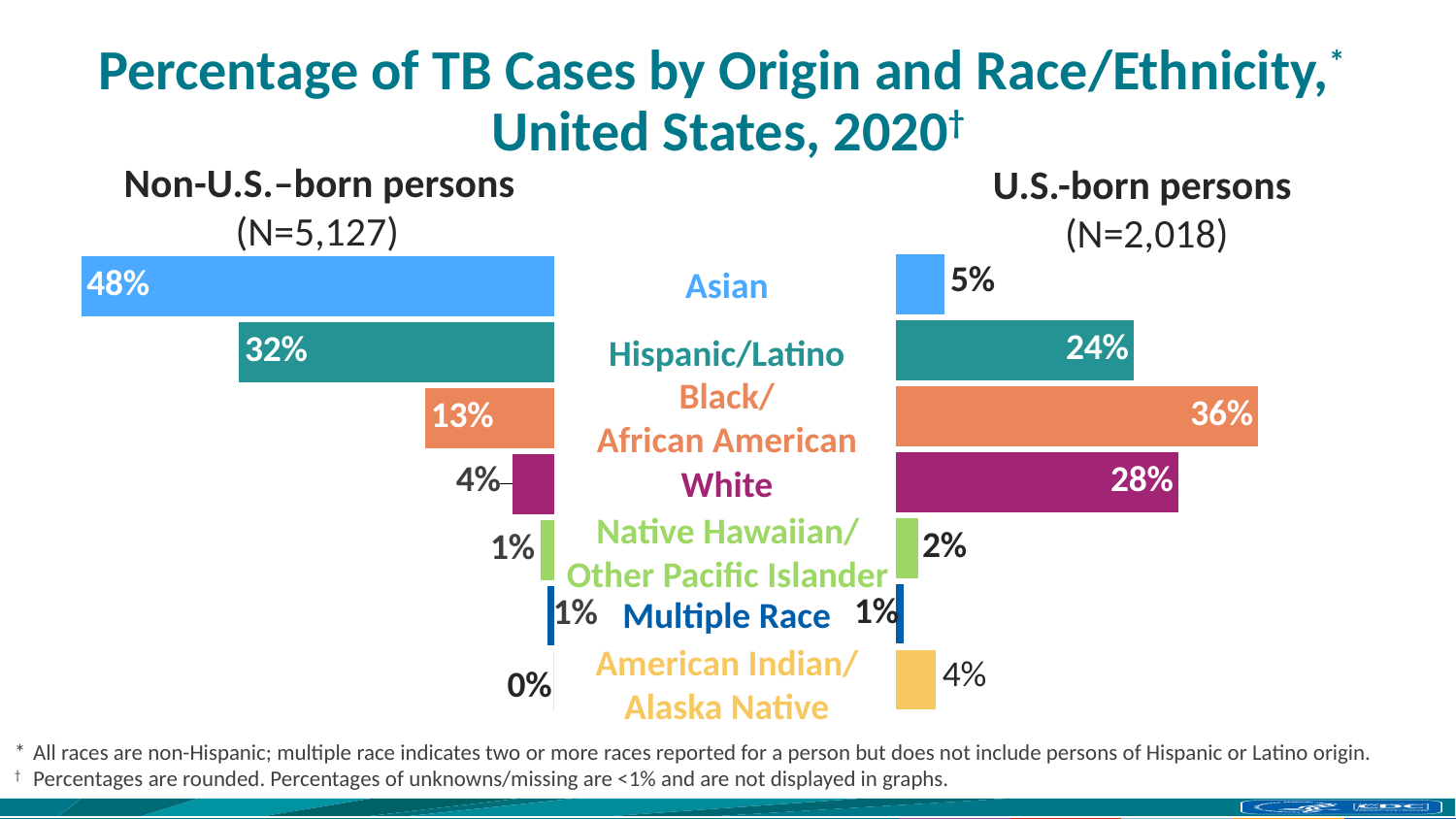
In the Non-U.S.-born persons chart, what is the difference between the percentages for Asian and Hispanic/Latino persons? 16% What kind of chart is used to show the Non-U.S.-born persons data? Bar chart In the U.S.-born persons chart, which race/ethnicity category has the highest percentage? Black/African American In the Non-U.S.-born persons chart, which race/ethnicity category has the lowest percentage? American Indian/Alaska Native Which chart shows a larger percentage for White persons, Non-U.S.-born persons or U.S.-born persons? U.S.-born persons In the Non-U.S.-born persons chart, which race/ethnicity category has the highest percentage? Asian In the U.S.-born persons chart, what is the difference between the percentages for Black/African American and Hispanic/Latino persons? 12% How many race/ethnicity categories are shown in the U.S.-born persons chart? 7 In the Non-U.S.-born persons chart, what percentage of TB cases is shown for Hispanic/Latino persons? 32% In the U.S.-born persons chart, what percentage of TB cases is shown for Black/African American persons? 36% In the Non-U.S.-born persons chart, what percentage of TB cases is shown for Asian persons? 48% In the U.S.-born persons chart, what percentage of TB cases is shown for White persons? 28%